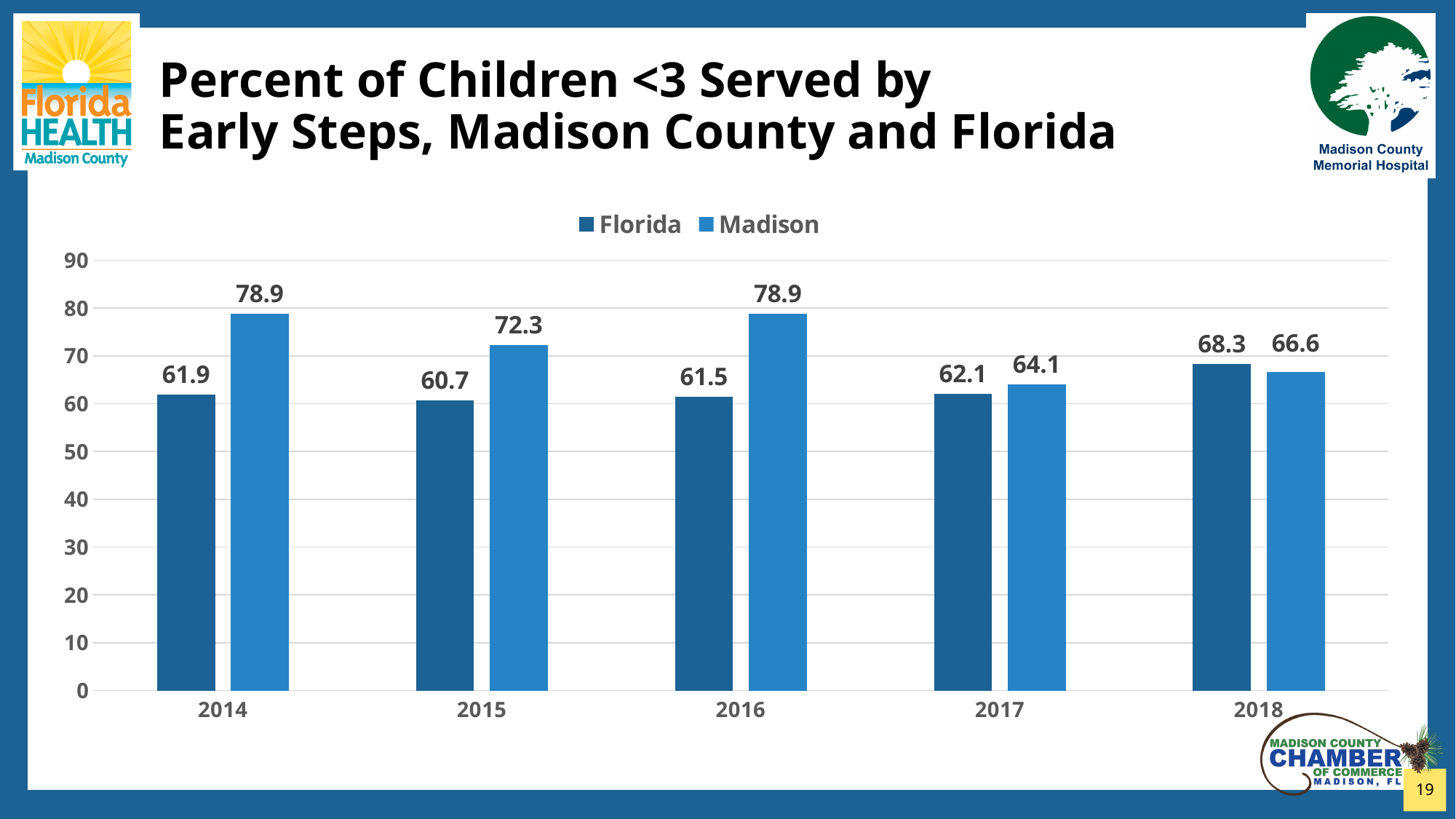
What is the difference between the Madison and Florida values in 2014? 17.0 What is the Florida value for 2014? 61.9 What is the Florida value for 2018? 68.3 In 2018, which is larger, the Florida value or the Madison value? Florida How many series does the legend list? 2 What kind of chart is shown on the slide? Bar chart In which year is the Florida value lowest? 2015 Which series is shown in the darker blue colour? Florida What is the difference between the Madison values for 2016 and 2017? 14.8 In which year is the Madison value lowest? 2017 How many years are shown on the x axis? 5 What is the Madison value for 2015? 72.3